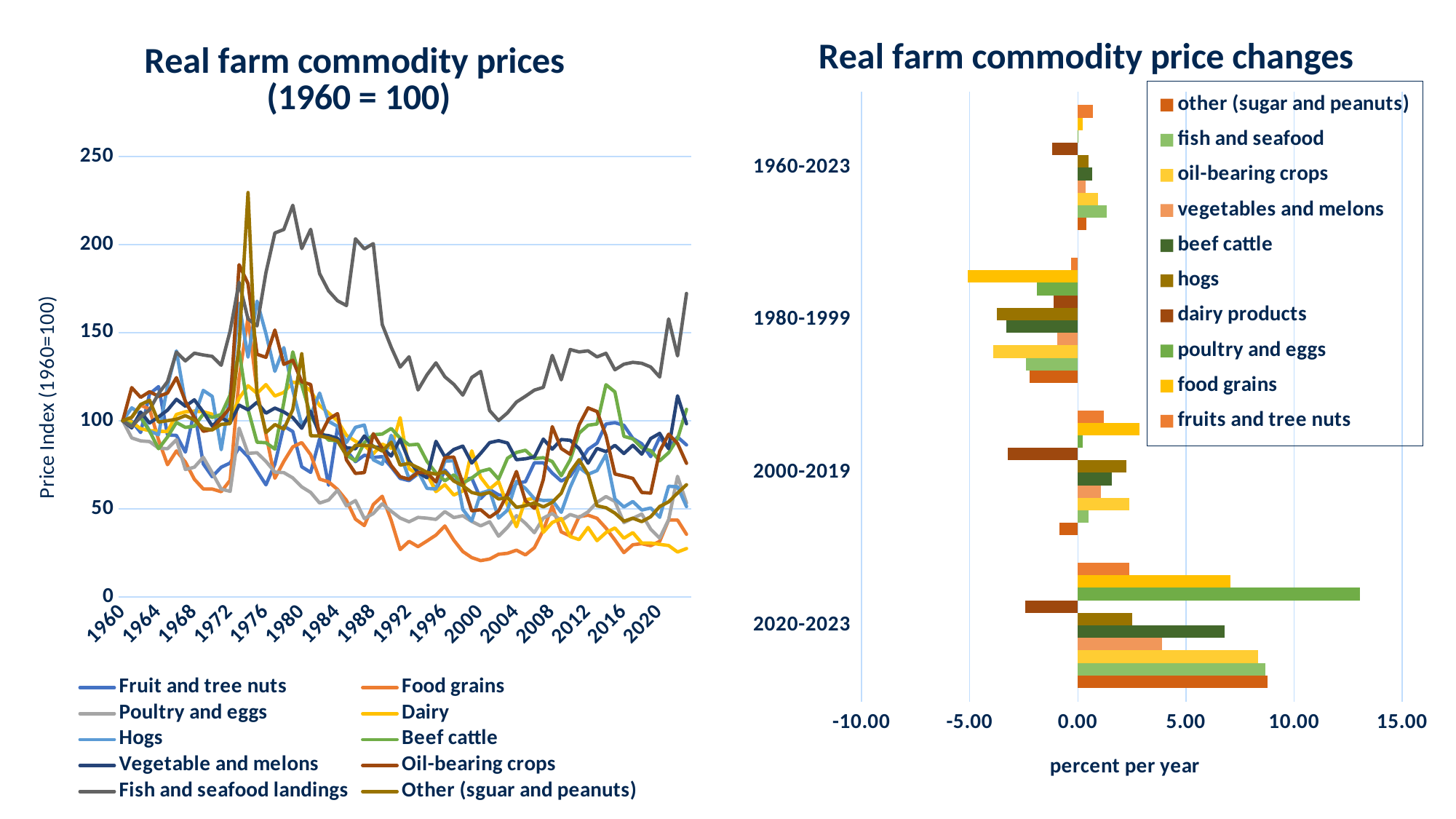
In the left chart "Real farm commodity prices (1960 = 100)", how many series does the legend list? 10 In the left chart "Real farm commodity prices (1960 = 100)", does the Food grains series rise or fall overall from 1960 to 2000? fall In the right chart "Real farm commodity price changes", how many time periods are shown on the vertical axis? 4 In the left chart "Real farm commodity prices (1960 = 100)", is the value for Food grains in 2000 greater or less than 50? less What kind of chart is the left chart titled "Real farm commodity prices (1960 = 100)"? line chart In the right chart "Real farm commodity price changes", which series has the highest value in the 2020-2023 period? poultry and eggs In the right chart "Real farm commodity price changes", is the value for dairy products in 2020-2023 greater or less than 0.00? less In the right chart "Real farm commodity price changes", which series has the lowest value in the 1980-1999 period? food grains In the right chart "Real farm commodity price changes", how many series does the legend list? 10 What is the x-axis label of the right chart "Real farm commodity price changes"? percent per year What kind of chart is the right chart titled "Real farm commodity price changes"? bar chart In the right chart "Real farm commodity price changes", is the value for poultry and eggs in 2020-2023 greater or less than 10.00? greater